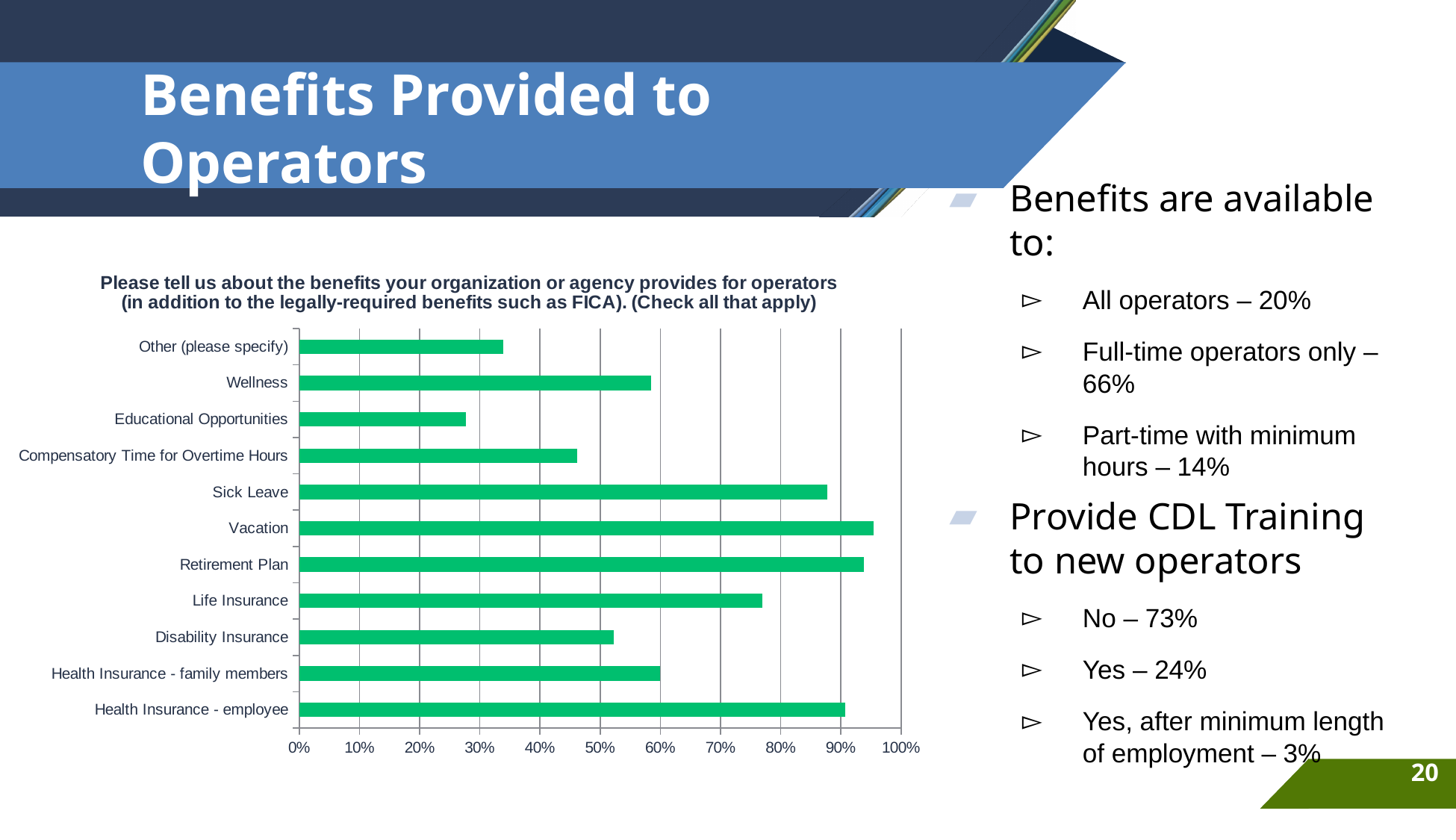
What kind of chart is shown on the slide? bar chart Is the value for Life Insurance greater or less than 70%? greater How many benefit categories are plotted in the chart? 11 Which is larger, the value for Health Insurance - employee or Health Insurance - family members? Health Insurance - employee What is the maximum value shown on the chart's horizontal axis? 100% Is the value for Compensatory Time for Overtime Hours greater or less than 50%? less Is the value for Health Insurance - employee greater or less than 80%? greater Which is larger, the value for Wellness or Educational Opportunities? Wellness Which benefit category has the lowest value in the chart? Educational Opportunities